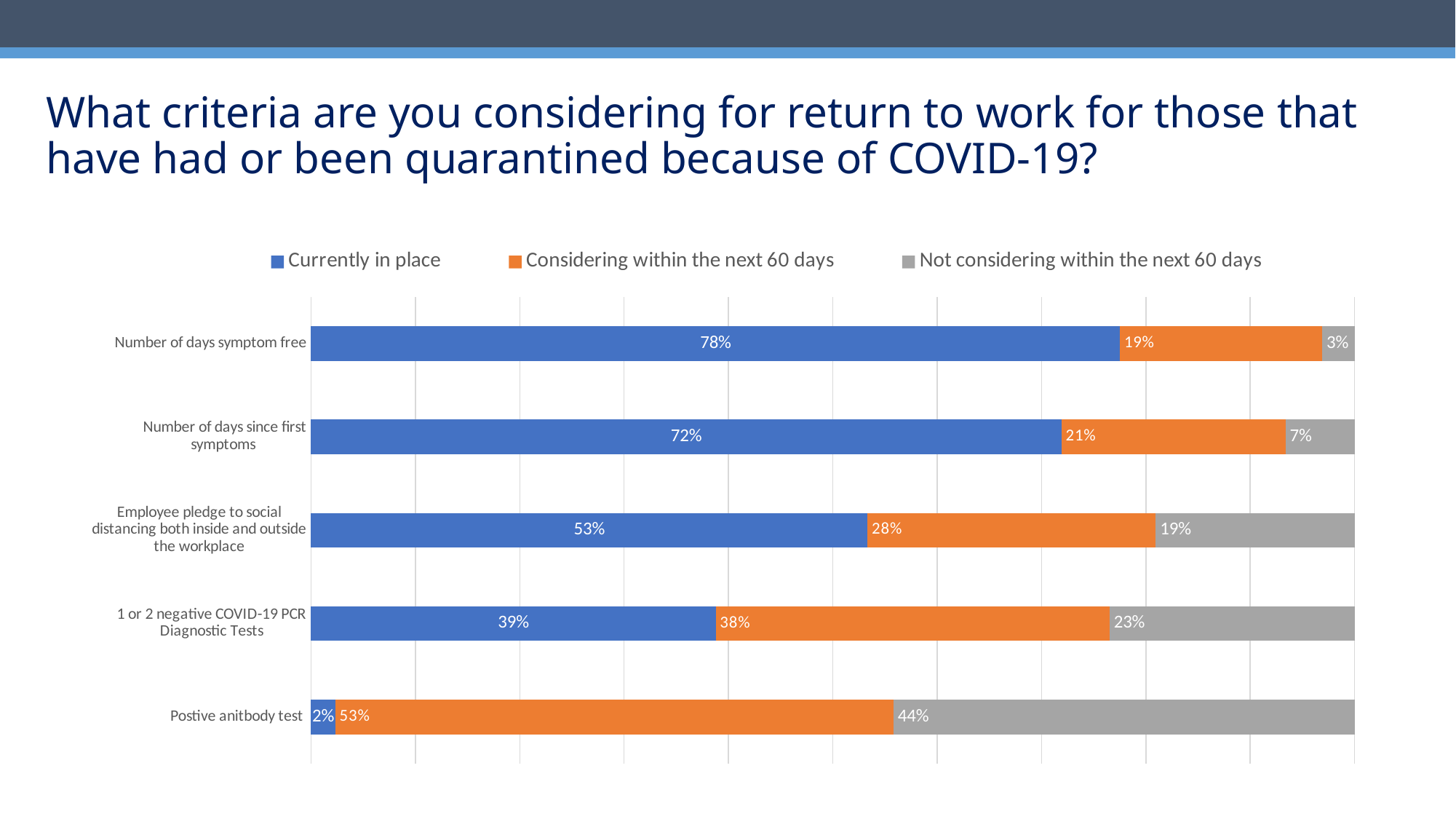
How many series does the legend list? 3 What is the total of the stacked bar for 'Employee pledge to social distancing both inside and outside the workplace'? 100% What is the difference between the 'Currently in place' values for 'Number of days symptom free' and 'Number of days since first symptoms'? 6% Which is larger: the 'Considering within the next 60 days' value for 'Employee pledge to social distancing both inside and outside the workplace' or for 'Number of days since first symptoms'? Employee pledge to social distancing both inside and outside the workplace What percentage of respondents currently have 'Number of days symptom free' in place? 78% What is the 'Considering within the next 60 days' value for '1 or 2 negative COVID-19 PCR Diagnostic Tests'? 38% How many criteria (categories) are shown in the chart? 5 Which colour represents 'Not considering within the next 60 days' in the legend? Grey What is the 'Not considering within the next 60 days' value for 'Postive anitbody test'? 44% What kind of chart is shown on the slide? Stacked bar chart Which criterion has the lowest 'Currently in place' percentage? Postive anitbody test Which criterion has the highest 'Currently in place' percentage? Number of days symptom free